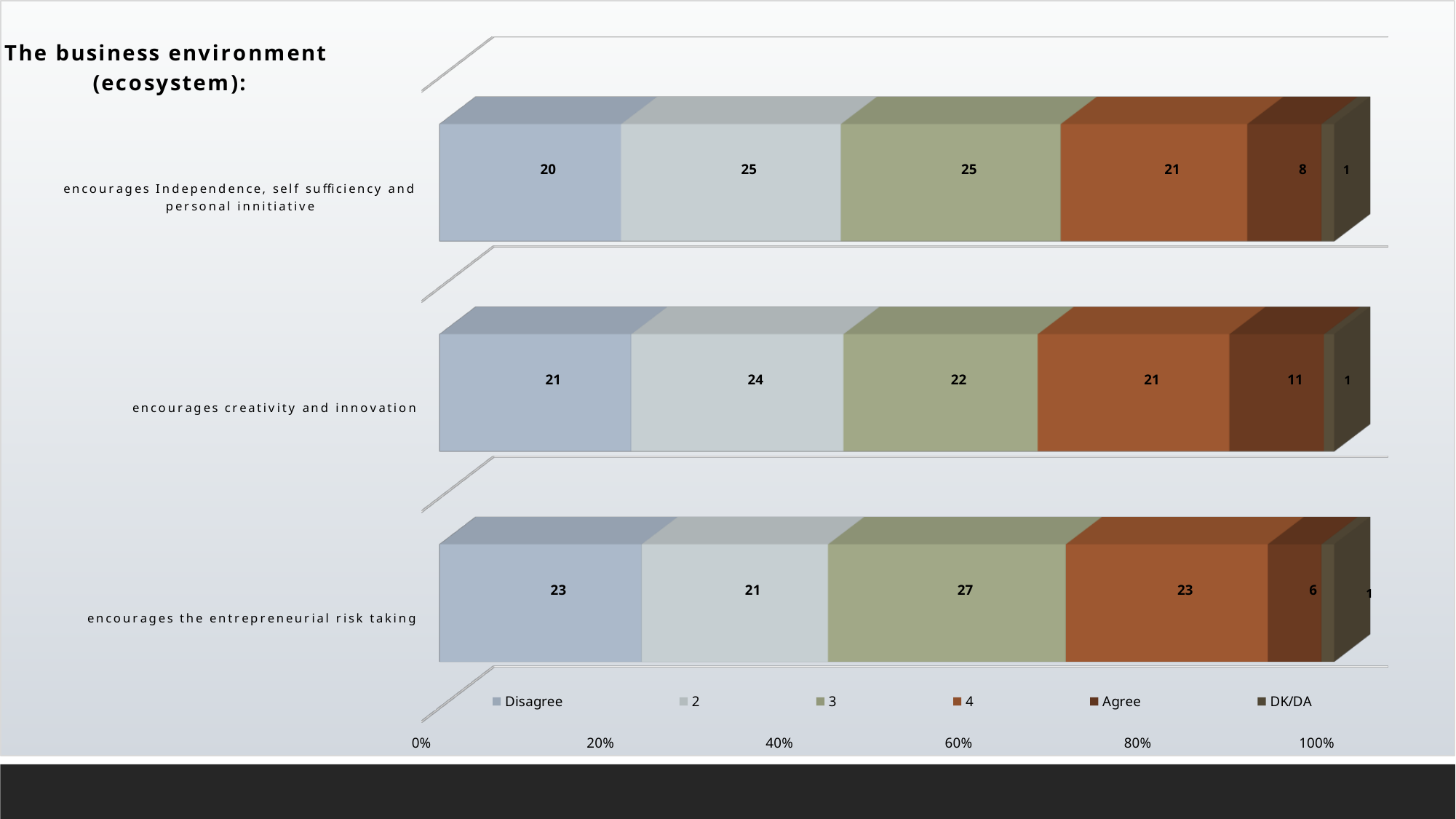
What is the value for series "3" in the "encourages Independence, self sufficiency and personal innitiative" bar? 25 Which category has the highest value for "Agree"? encourages creativity and innovation What is the total of the "encourages creativity and innovation" stacked bar? 100 How many series does the legend list? 6 Which category has the lowest value for "Agree"? encourages the entrepreneurial risk taking What is the difference between the "Agree" values for "encourages creativity and innovation" and "encourages the entrepreneurial risk taking"? 5 How many categories (bars) are shown in the chart? 3 What is the value for "Disagree" in the "encourages the entrepreneurial risk taking" bar? 23 What is the value for "Agree" in the "encourages creativity and innovation" bar? 11 What is the title of the chart? The business environment (ecosystem): What kind of chart is shown on the slide? Stacked bar chart Which is larger: the value for series "3" in "encourages the entrepreneurial risk taking" or in "encourages creativity and innovation"? encourages the entrepreneurial risk taking